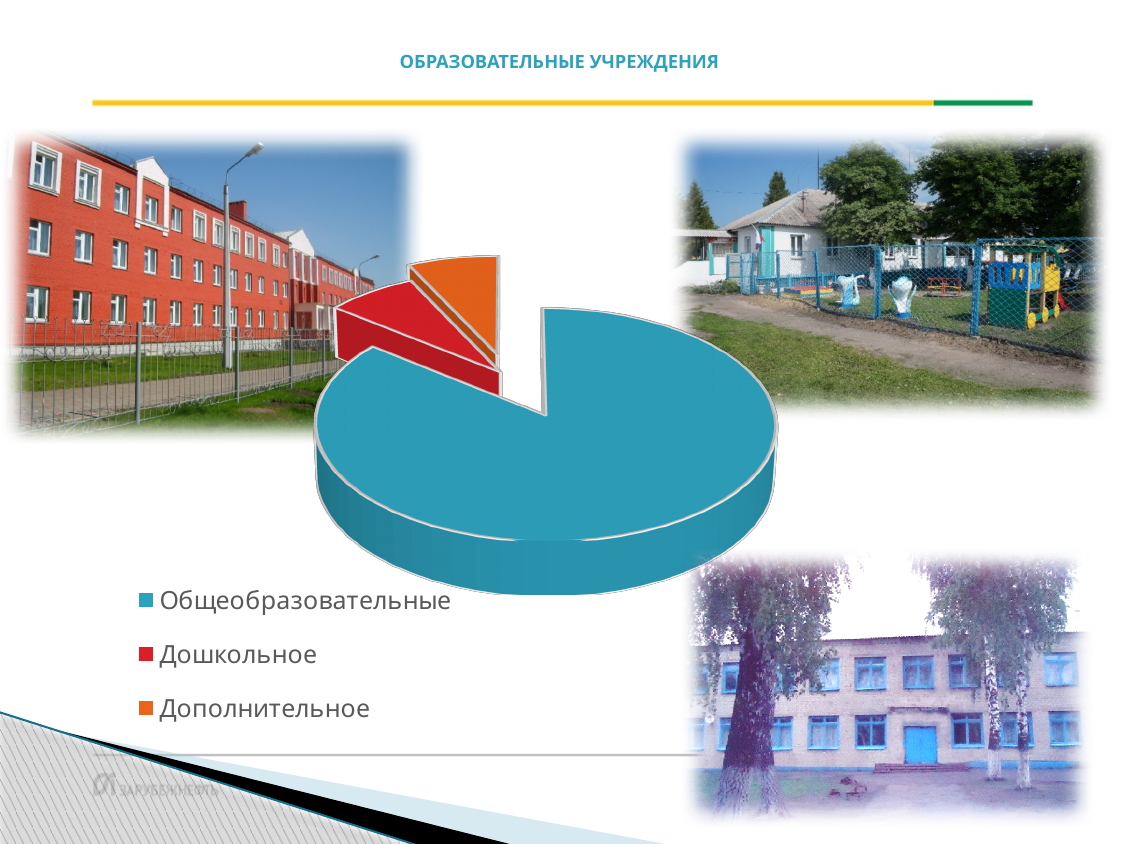
Which category has the largest slice in the pie chart? Общеобразовательные Which slice is larger in the pie chart, Общеобразовательные or Дошкольное? Общеобразовательные How many slices does the pie chart have? 3 How many entries does the legend of the pie chart list? 3 What kind of chart is shown on the slide? pie chart What is the title of the slide containing the pie chart? ОБРАЗОВАТЕЛЬНЫЕ УЧРЕЖДЕНИЯ What colour is the Дошкольное slice in the pie chart? red